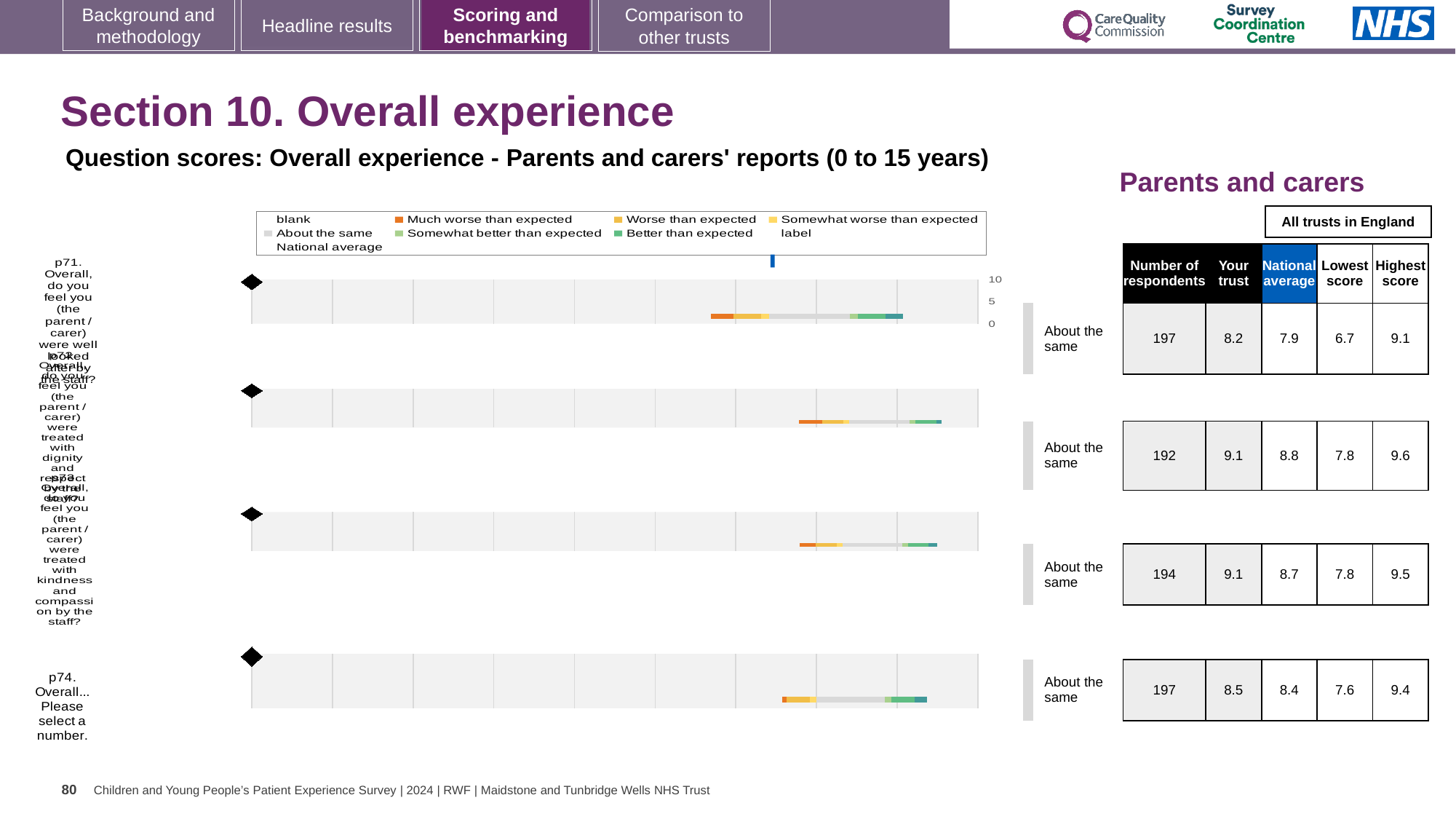
What is the 'Your trust' score for p71 (Overall, do you feel you were well looked after by the staff?)? 8.2 What kind of chart is shown on the slide? bar chart For p73, which is larger: the 'Your trust' score or the national average? Your trust How many questions (bars) are plotted in the chart? 4 What is the number of respondents for p72? 192 What is the highest score across all trusts in England for p72? 9.6 What is the national average score for p71? 7.9 What benchmark category is shown for all four questions in the chart? About the same What is the difference between the 'Your trust' score and the national average for p71? 0.3 What is the difference between the highest score and the lowest score for p74? 1.8 Which question has the lowest 'Your trust' score? p71 What is the 'Your trust' score for p74 (Overall... Please select a number)? 8.5